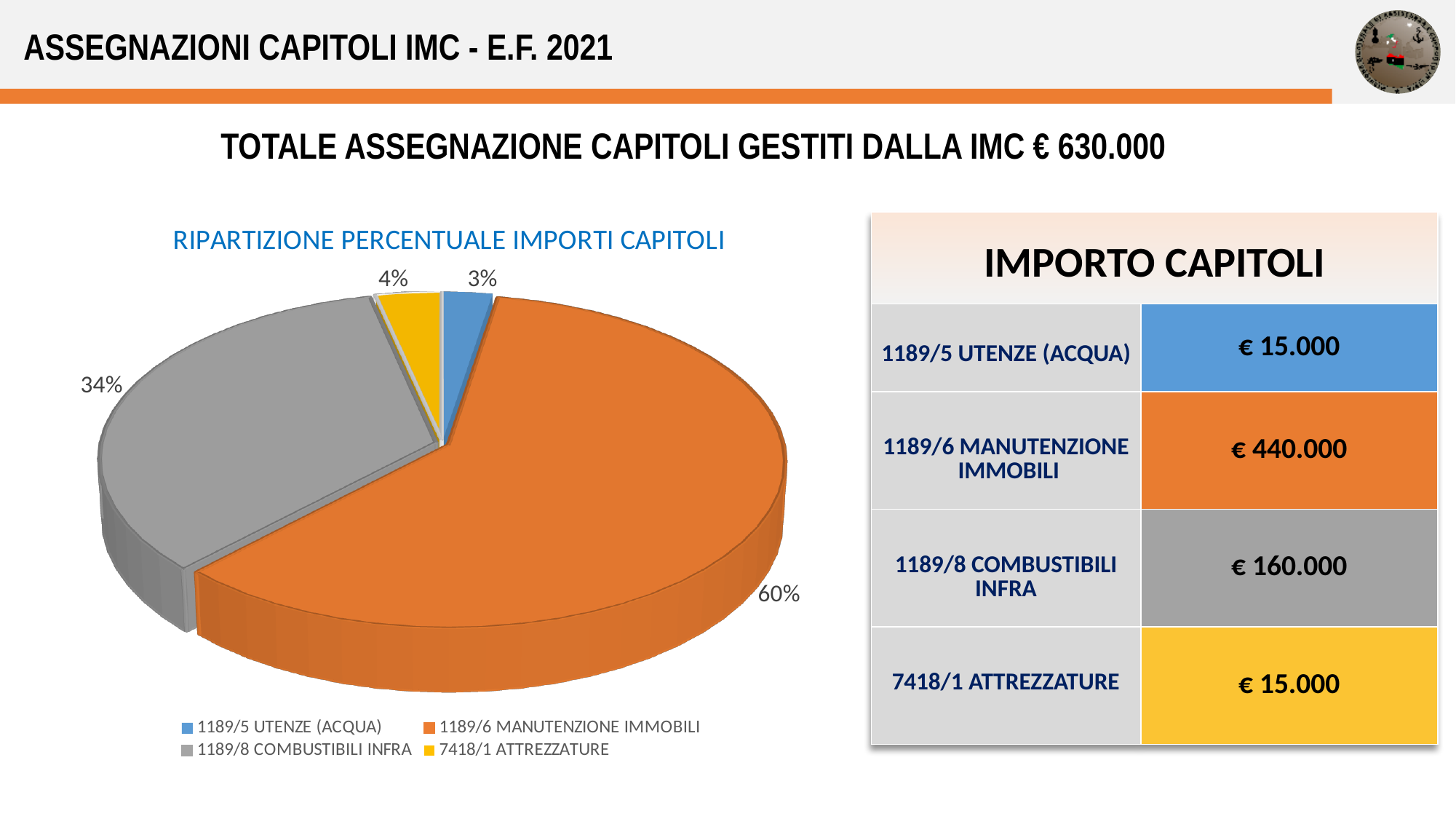
Which category has the smallest slice of the pie? 1189/5 UTENZE (ACQUA) Which slice is larger, 7418/1 ATTREZZATURE or 1189/5 UTENZE (ACQUA)? 7418/1 ATTREZZATURE What kind of chart is shown on the slide? pie chart What percentage of the pie does 1189/6 MANUTENZIONE IMMOBILI represent? 60% What percentage of the pie does 1189/8 COMBUSTIBILI INFRA represent? 34% What percentage of the pie does 1189/5 UTENZE (ACQUA) represent? 3% How many slices does the pie chart have? 4 What is the difference in percentage points between the 1189/6 MANUTENZIONE IMMOBILI slice and the 1189/8 COMBUSTIBILI INFRA slice? 26% How many entries does the legend of the pie chart list? 4 What is the title of the pie chart? RIPARTIZIONE PERCENTUALE IMPORTI CAPITOLI Which category has the largest slice of the pie? 1189/6 MANUTENZIONE IMMOBILI